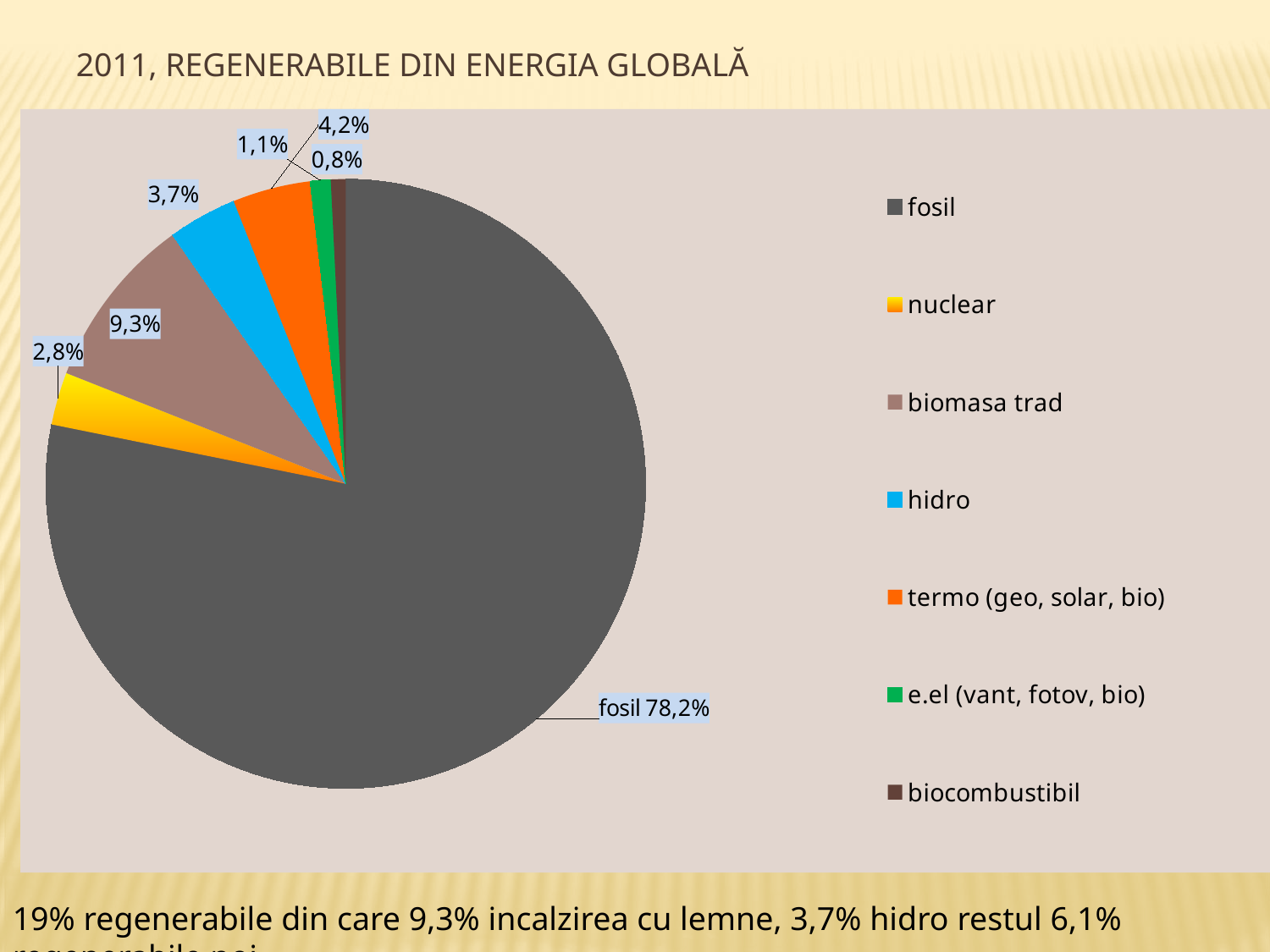
What is the value for biomasa trad? 9,3% What share of the pie does fosil have? 78,2% What is the value for termo (geo, solar, bio)? 4,2% Which category has the largest slice of the pie? fosil What is the value for hidro? 3,7% Which category has the smallest slice of the pie? biocombustibil What type of chart is shown on the slide? pie chart How many categories does the legend list? 7 What is the value for biocombustibil? 0,8% What is the value for nuclear? 2,8% Which is larger, hidro or termo (geo, solar, bio)? termo (geo, solar, bio) What is the difference between biomasa trad and hidro? 5,6%